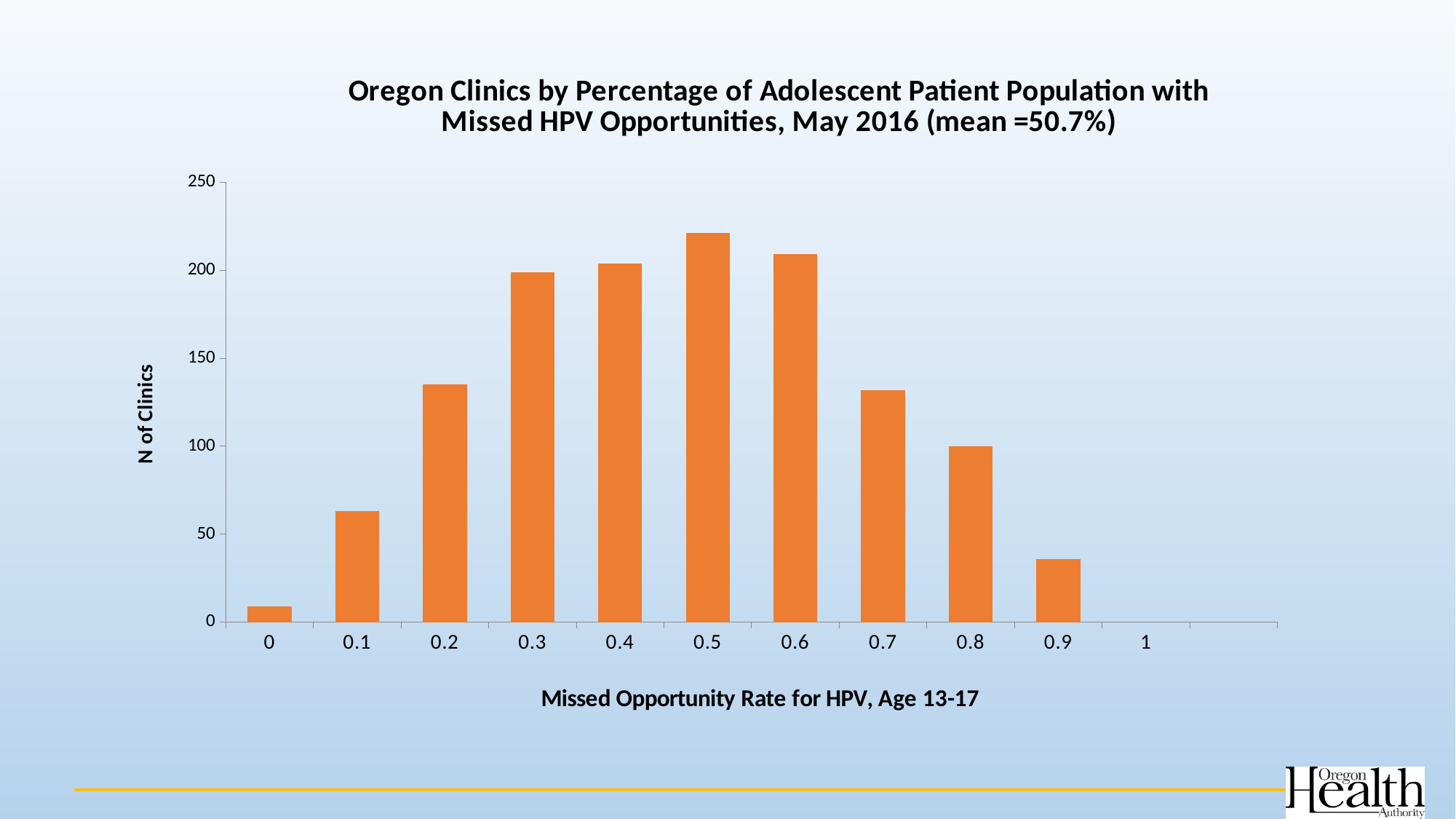
Which category has more clinics, 0.2 or 0.8? 0.2 Which category has more clinics, 0.1 or 0.9? 0.1 Is the number of clinics for the 0.2 category greater or less than 150? less Is the number of clinics for the 0.1 category greater or less than 50? greater How many categories are labeled on the x axis? 11 Is the number of clinics for the 0.9 category greater or less than 50? less What kind of chart is shown on the slide? bar chart Which missed opportunity rate category has the highest number of clinics? 0.5 What mean value is stated in the chart title? 50.7% Do the bars rise or fall from the 0.5 category to the 0.9 category? fall